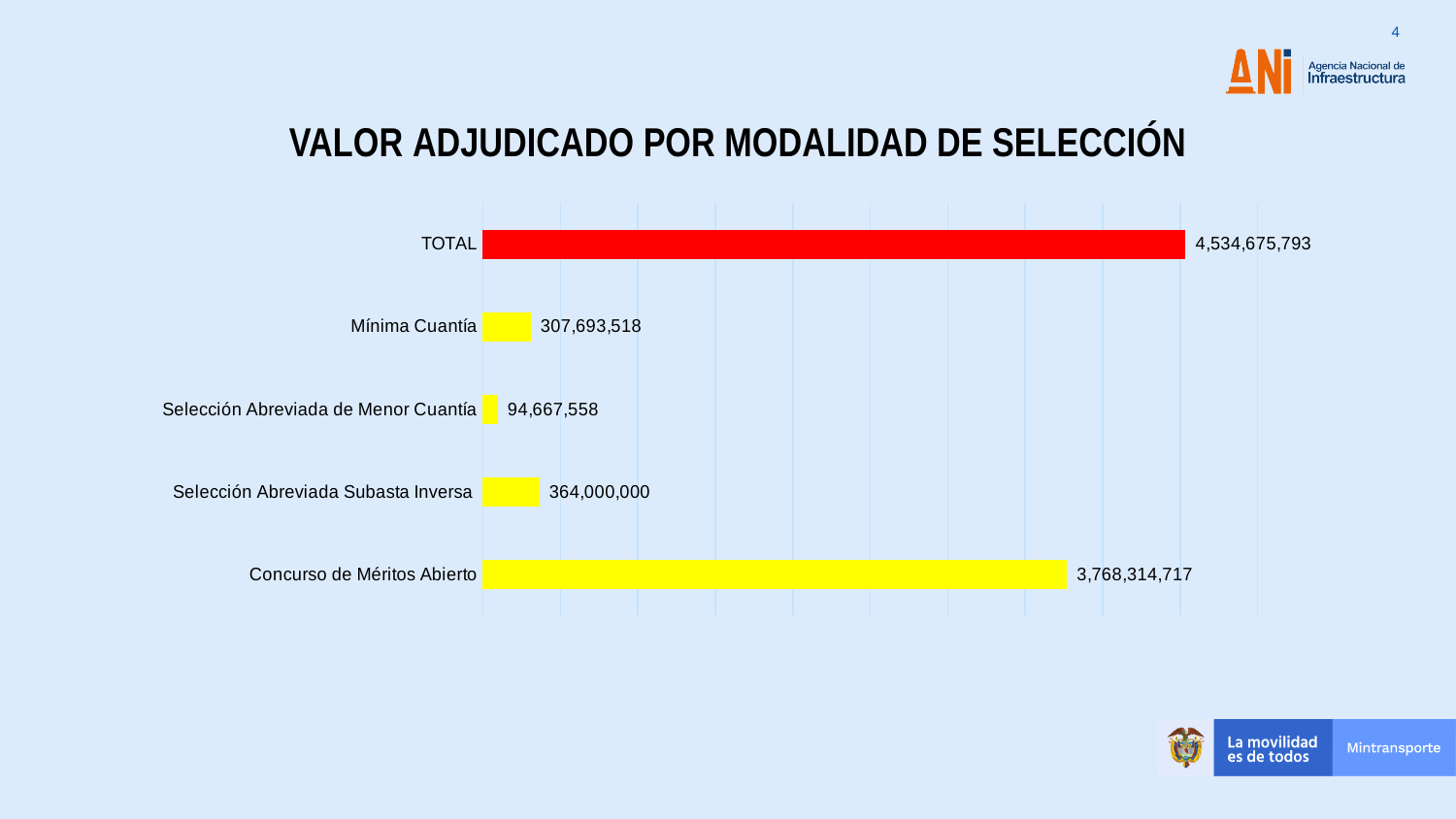
How many bars are shown in the chart? 5 What is the value for TOTAL? 4,534,675,793 Which is larger, Mínima Cuantía or Selección Abreviada Subasta Inversa? Selección Abreviada Subasta Inversa What type of chart is shown on the slide? Bar chart Excluding TOTAL, which selection modality has the highest value? Concurso de Méritos Abierto What is the value for Selección Abreviada Subasta Inversa? 364,000,000 What is the value for Mínima Cuantía? 307,693,518 What is the value for Concurso de Méritos Abierto? 3,768,314,717 What is the value for Selección Abreviada de Menor Cuantía? 94,667,558 Which category has the lowest value? Selección Abreviada de Menor Cuantía What is the title of the chart? VALOR ADJUDICADO POR MODALIDAD DE SELECCIÓN What is the difference between Selección Abreviada Subasta Inversa and Mínima Cuantía? 56,306,482